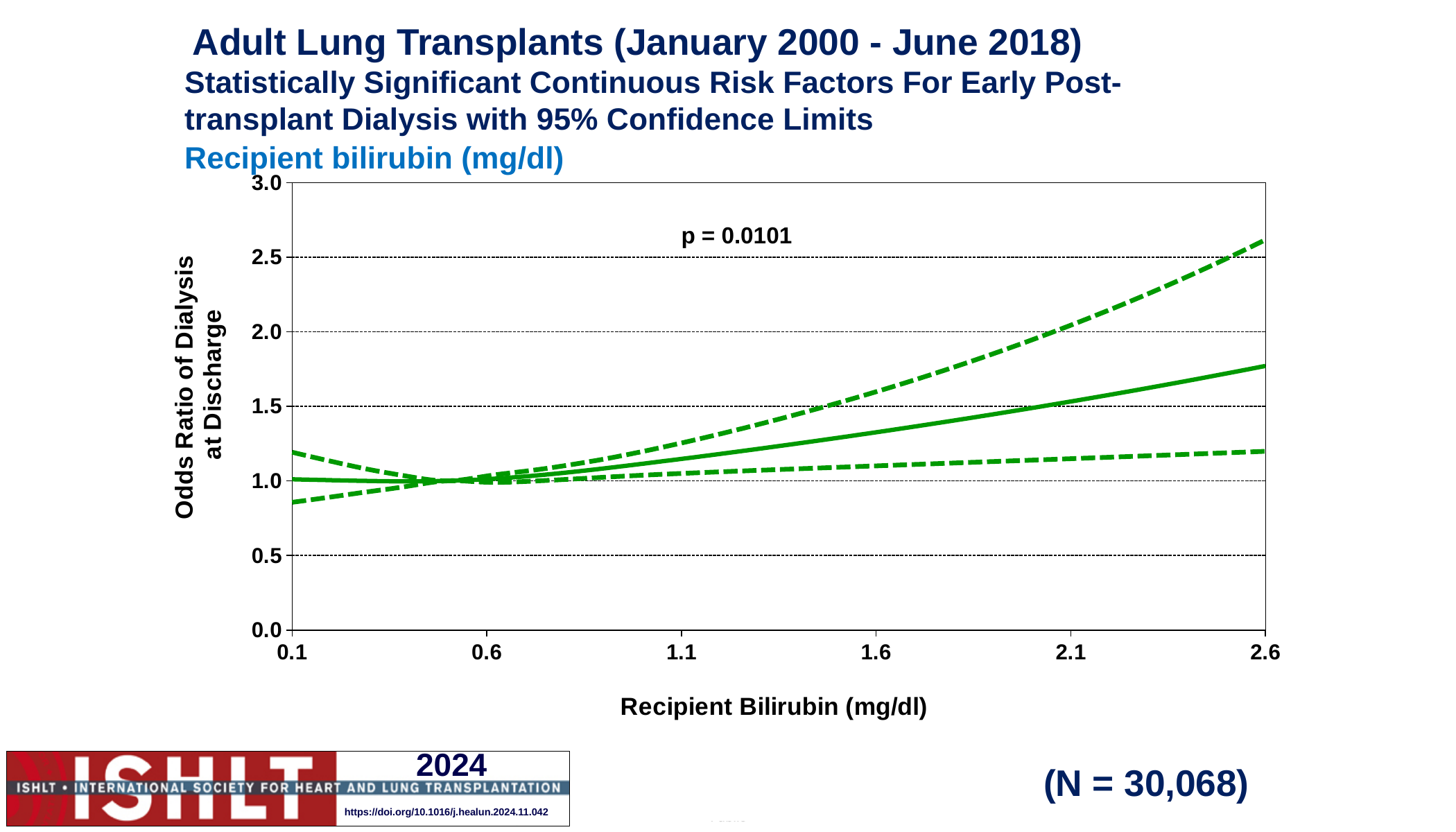
Is the lower dashed confidence limit at a recipient bilirubin of 2.6 mg/dl greater or less than 1.5? less Is the upper dashed confidence limit at a recipient bilirubin of 0.1 mg/dl greater or less than 1.5? less Does the solid odds ratio line rise or fall as recipient bilirubin increases from 0.1 to 2.6 mg/dl? rise What p-value is printed on the chart? p = 0.0101 Is the lower dashed confidence limit at a recipient bilirubin of 0.1 mg/dl greater or less than 1.0? less What kind of chart is shown on the slide? line chart How many lines are plotted on the chart? 3 What is the label of the y axis? Odds Ratio of Dialysis at Discharge